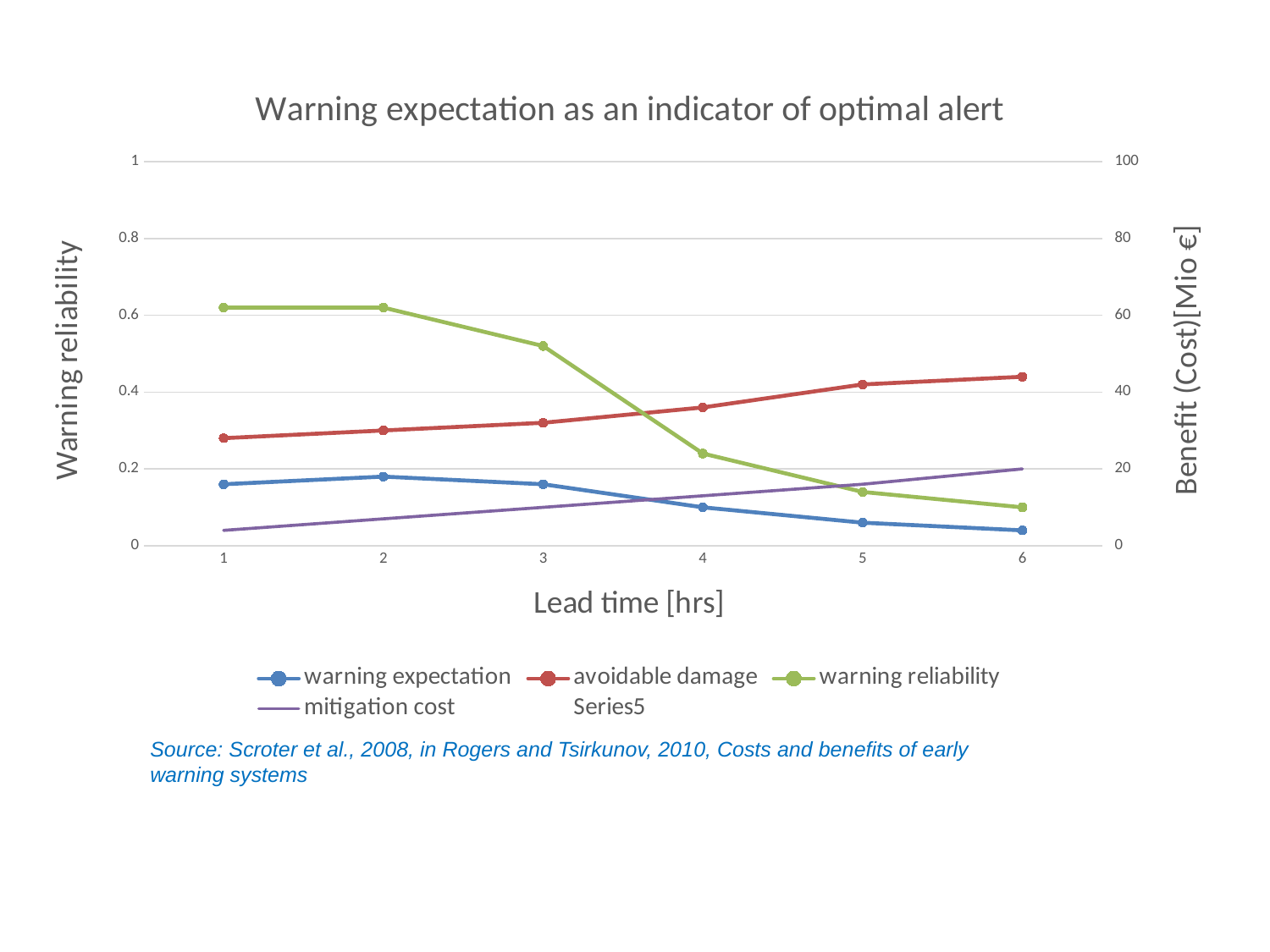
How many series does the legend list? 5 Is the value for avoidable damage at lead time 6 greater or less than 0.4? greater Does the avoidable damage series rise or fall as lead time increases? rise What is the title of the chart? Warning expectation as an indicator of optimal alert At which lead time is avoidable damage highest? 6 How many lead time points are plotted along the x axis? 6 Does the warning reliability series rise or fall as lead time increases? fall What is the label of the x axis? Lead time [hrs] What kind of chart is shown on the slide? line chart Is the value for warning reliability at lead time 6 greater or less than 0.2? less At lead time 4, which is larger: warning reliability or avoidable damage? avoidable damage At which lead time is warning reliability lowest? 6